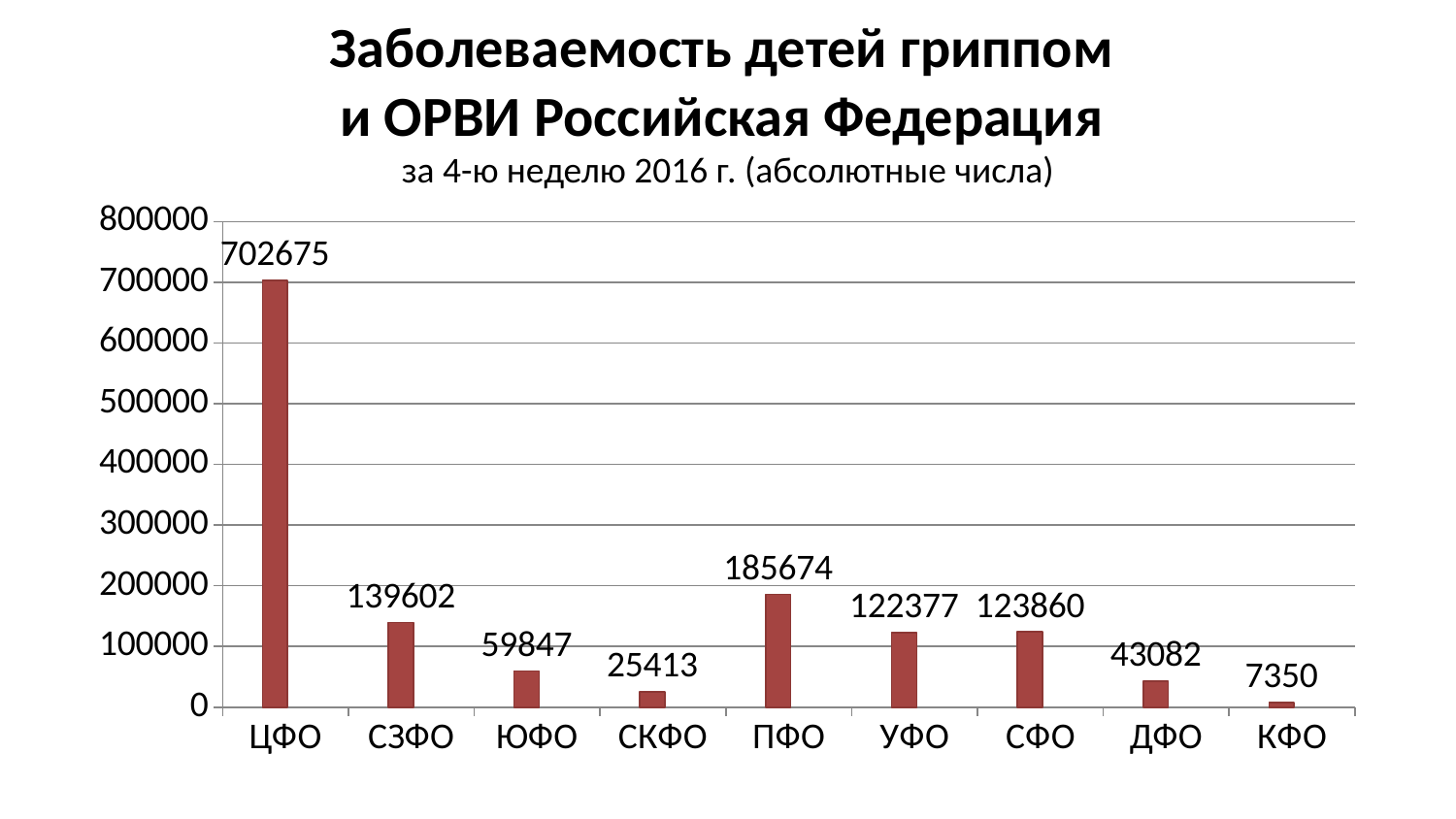
What is the value for ДФО? 43082 How many categories are shown on the x axis? 9 What is the value for КФО? 7350 What kind of chart is shown on the slide? bar chart What is the value for ЦФО? 702675 What is the difference between the values for ЮФО and СКФО? 34434 Which category has the lowest value? КФО What is the difference between the values for ПФО and СЗФО? 46072 Which category has the highest value? ЦФО Is the value for ЦФО greater or less than 600000? greater What is the value for ПФО? 185674 Which is larger, the value for СЗФО or the value for ЮФО? СЗФО